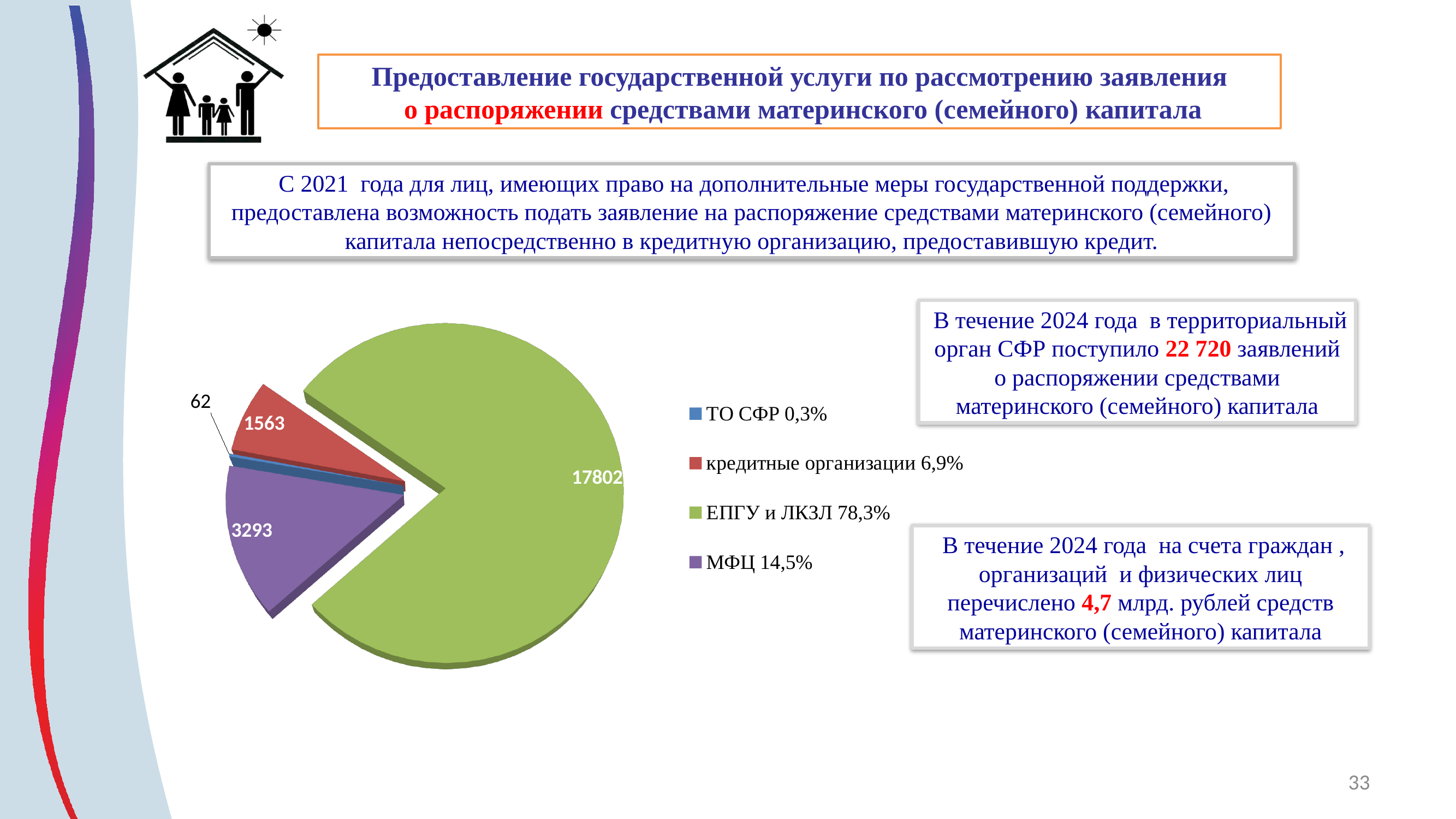
What is the difference between the МФЦ value and the кредитные организации value? 1730 Which is larger: the value for МФЦ or the value for кредитные организации? МФЦ What is the value shown for the ТО СФР slice? 62 Which category has the largest slice of the pie? ЕПГУ и ЛКЗЛ What share of the pie does МФЦ represent, according to the legend? 14,5% How many slices does the pie chart have? 4 What share of the pie does кредитные организации represent, according to the legend? 6,9% What is the value shown for the МФЦ slice? 3293 Which category has the smallest slice of the pie? ТО СФР What is the value shown for the ЕПГУ и ЛКЗЛ slice? 17802 What kind of chart is shown on the slide? pie chart What is the value shown for the кредитные организации slice? 1563